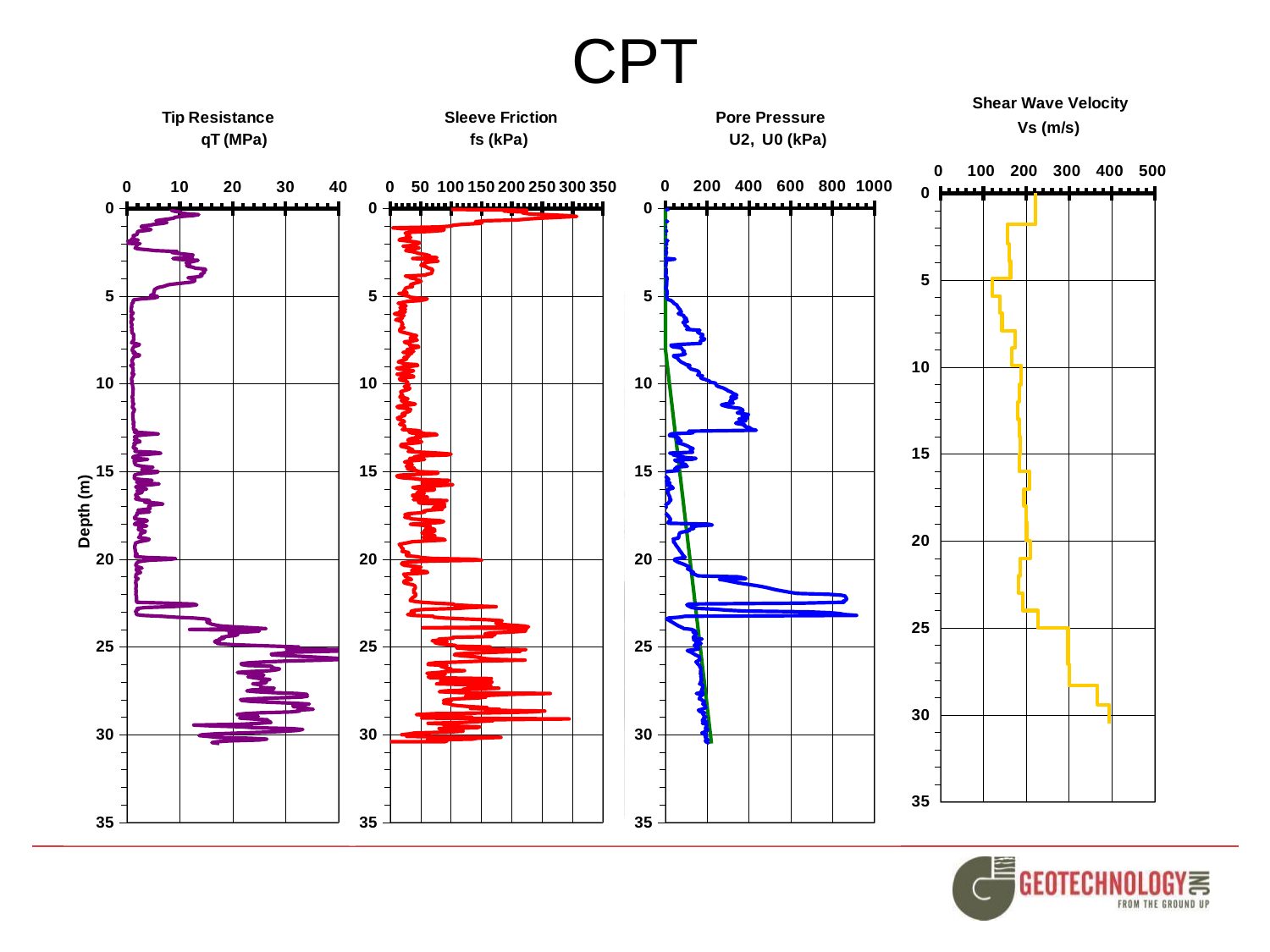
On the Shear Wave Velocity chart, is the value at a depth of 5 m greater or less than 200 m/s? less On the Shear Wave Velocity chart, is the value at a depth of 30 m greater or less than 300 m/s? greater What kind of chart is the Tip Resistance chart? line chart On the Tip Resistance chart, is the value at a depth of 10 m greater or less than 10 MPa? less On the Tip Resistance chart, what is the maximum value shown on the qT (MPa) axis? 40 How many charts are shown on the slide? 4 On the Pore Pressure chart, what is the maximum value shown on the horizontal axis? 1000